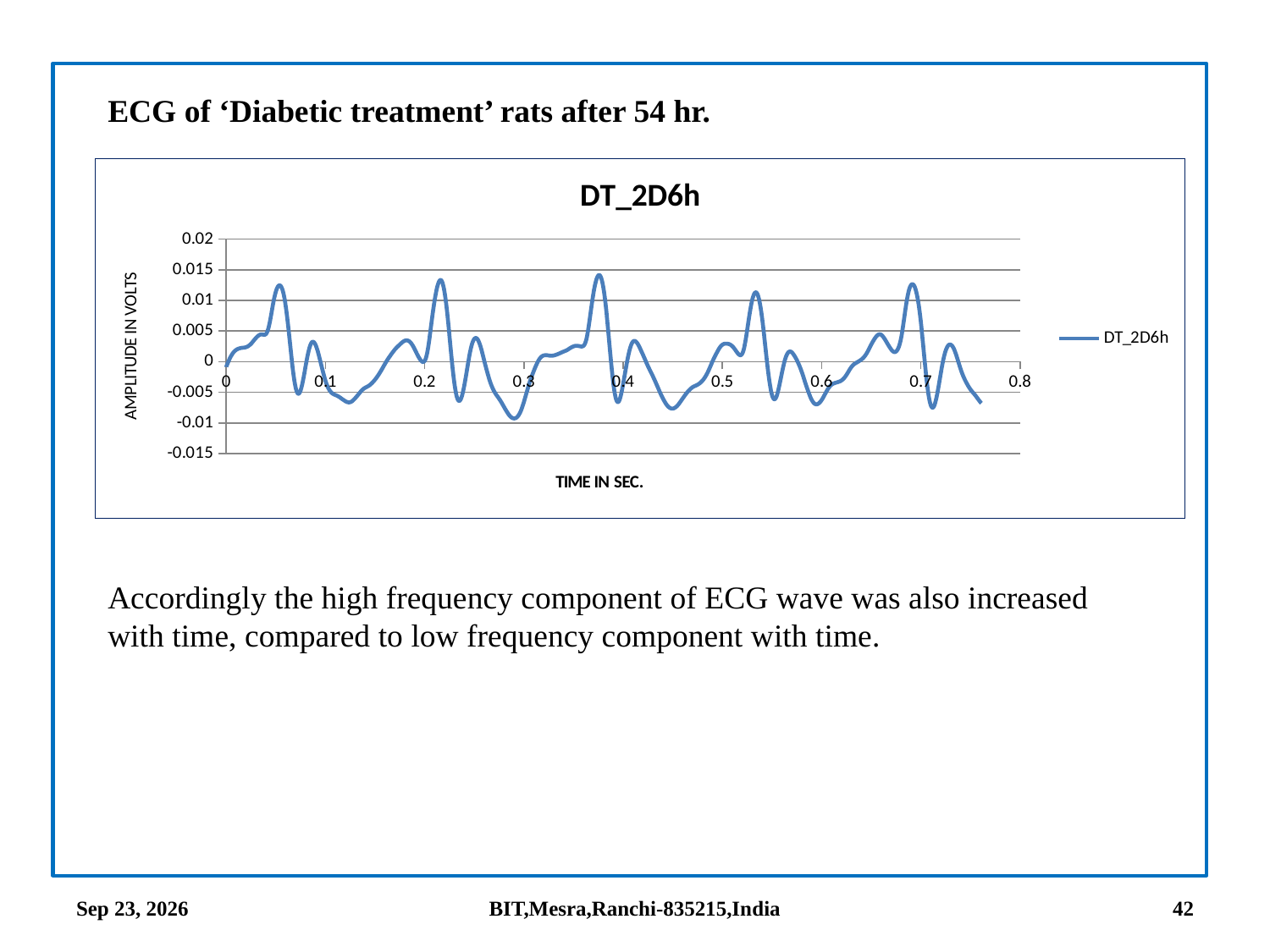
Is the value of the DT_2D6h line at time 0.1 greater or less than 0? less Is the peak of the DT_2D6h line near time 0.38 higher or lower than the peak near time 0.53? higher What is the title of the chart? DT_2D6h Does the DT_2D6h line ever drop below -0.015? no Is the highest value of the DT_2D6h line greater or less than 0.01? greater What is the largest tick value shown on the x axis of the chart? 0.8 How many peaks of the DT_2D6h line rise above 0.01? 5 How many series does the legend of the chart list? 1 What kind of chart is shown on the slide? line chart What is the label of the y axis of the chart? AMPLITUDE IN VOLTS